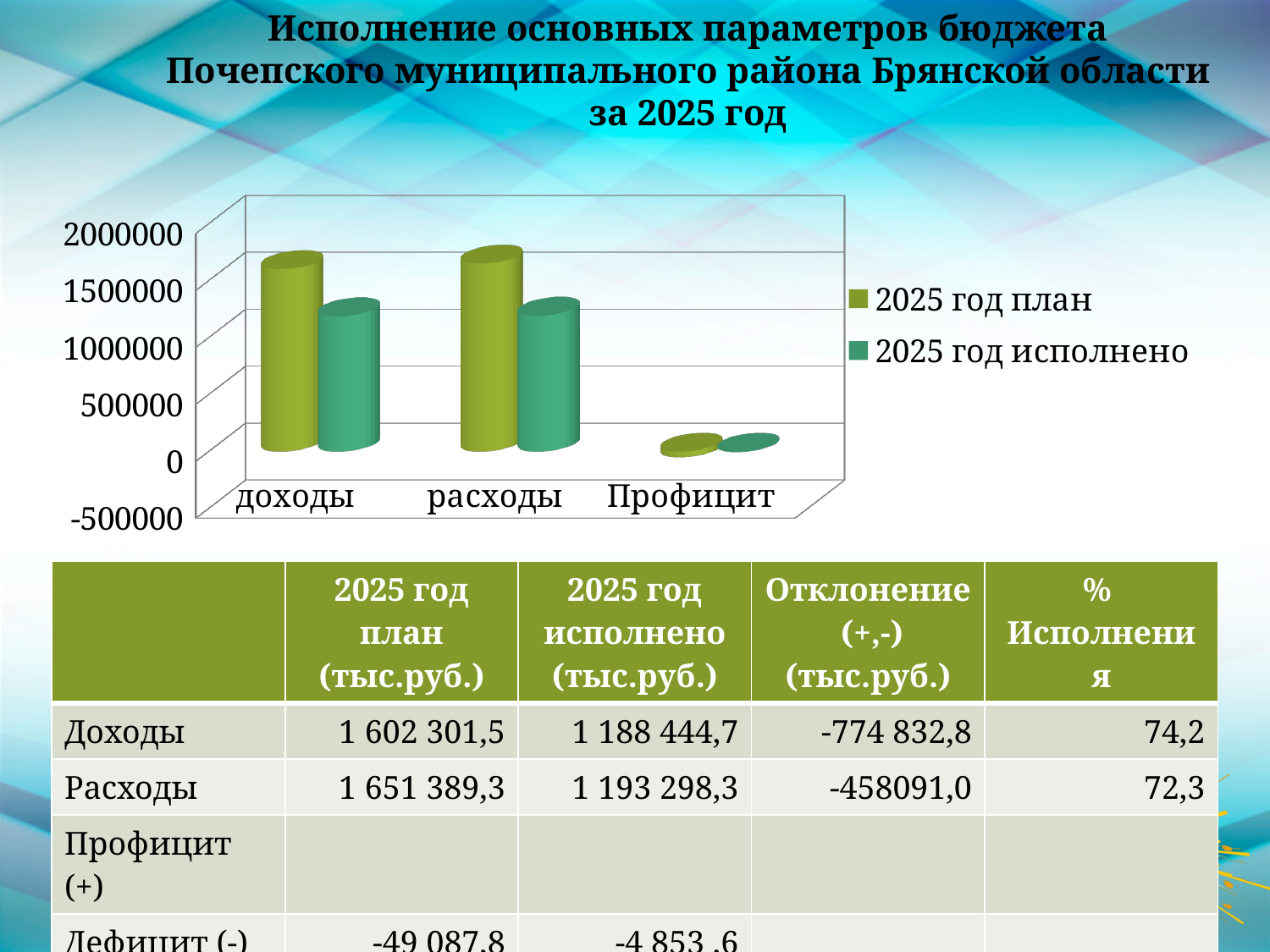
How many categories are shown on the x axis of the chart? 3 What kind of chart is shown on the slide? bar chart What are the two series named in the chart legend? 2025 год план; 2025 год исполнено Is the value for расходы in the 2025 год исполнено series greater or less than 1000000? greater Is the value for доходы in the 2025 год план series greater or less than 1500000? greater Which category has the lowest values for both series in the chart? Профицит For расходы, which series has the larger value: 2025 год план or 2025 год исполнено? 2025 год план For доходы, which series has the larger value: 2025 год план or 2025 год исполнено? 2025 год план How many series does the chart legend list? 2 Is the value for доходы in the 2025 год исполнено series greater or less than 1500000? less